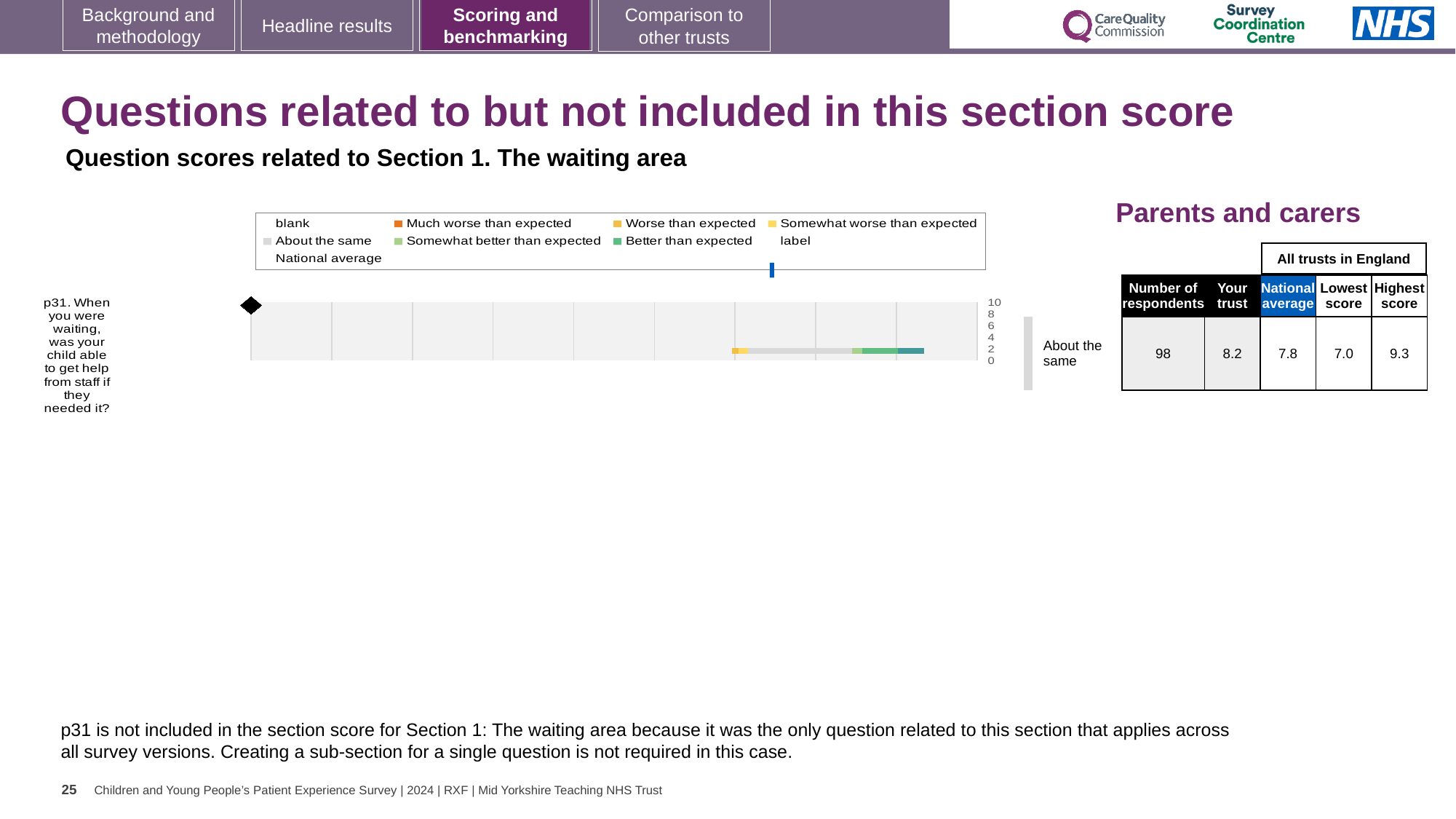
How many respondents answered p31? 98 Which is larger for p31: the 'Your trust' score or the national average? Your trust Which respondent group does the chart on this slide relate to? Parents and carers What kind of chart is used to show the p31 question score? bar chart What is the highest score among all trusts in England for p31? 9.3 How many survey questions are plotted in the chart? 1 By how much does the 'Your trust' score for p31 exceed the national average? 0.4 What is the national average score for p31? 7.8 What is the 'Your trust' score for p31 (When you were waiting, was your child able to get help from staff if they needed it?)? 8.2 What benchmark category is shown next to the chart for p31? About the same What is the difference between the highest score and the lowest score for p31? 2.3 What is the lowest score among all trusts in England for p31? 7.0